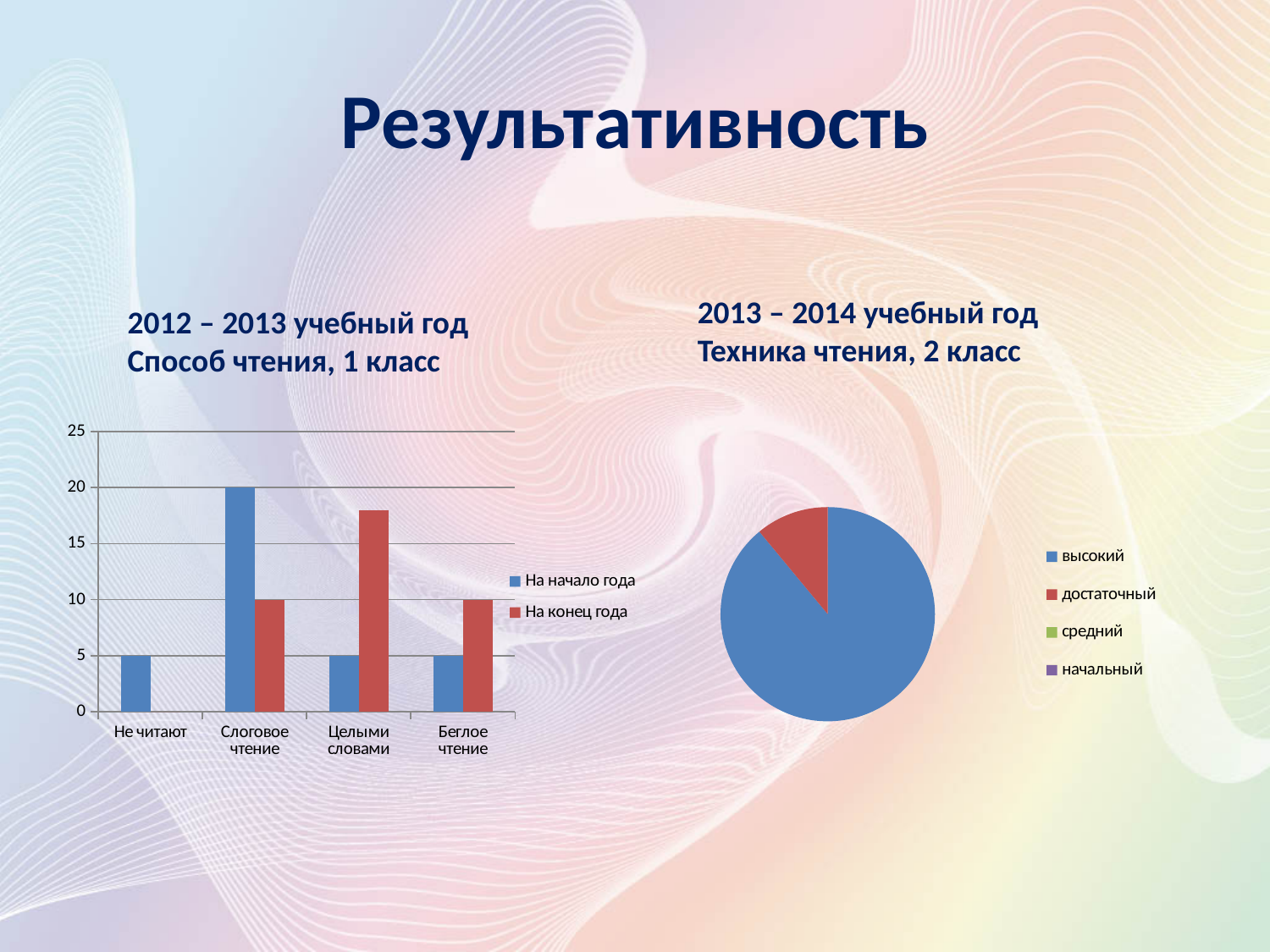
In the bar chart on the left (2012 – 2013 учебный год), which category has the highest value in the series На начало года? Слоговое чтение How many categories are shown on the x axis of the bar chart on the left (2012 – 2013 учебный год)? 4 In the bar chart on the left (2012 – 2013 учебный год), is the value for Целыми словами in the series На конец года greater or less than 15? greater In the bar chart on the left (2012 – 2013 учебный год), what is the value for Не читают in the series На начало года? 5 How many series does the legend of the bar chart on the left (2012 – 2013 учебный год) list? 2 In the bar chart on the left (2012 – 2013 учебный год), what is the value for Беглое чтение in the series На конец года? 10 What kind of chart is the chart on the right (2013 – 2014 учебный год, Техника чтения, 2 класс)? pie chart In the bar chart on the left (2012 – 2013 учебный год), what is the value for Слоговое чтение in the series На конец года? 10 In the bar chart on the left (2012 – 2013 учебный год), for Беглое чтение, which series has the larger value: На начало года or На конец года? На конец года In the bar chart on the left (2012 – 2013 учебный год), what is the difference between the На начало года and На конец года values for Слоговое чтение? 10 In the bar chart on the left (2012 – 2013 учебный год), what is the value for Слоговое чтение in the series На начало года? 20 In the pie chart on the right (2013 – 2014 учебный год), which category has the largest slice? высокий